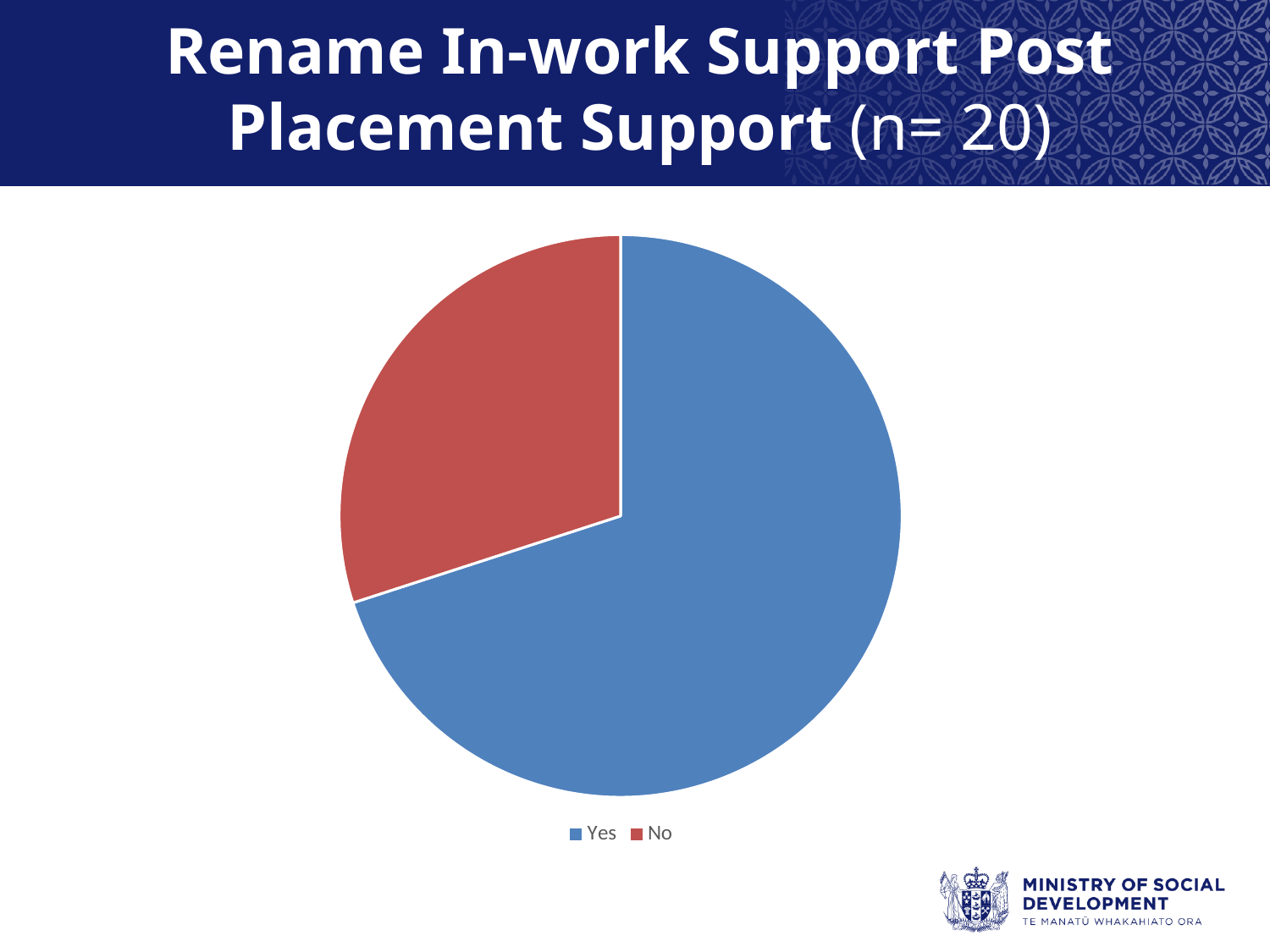
What colour is the No slice of the pie chart? red What are the two categories listed in the legend? Yes and No Which category has the largest slice of the pie? Yes Which is larger, the Yes slice or the No slice? Yes Which category has the smallest slice of the pie? No What kind of chart is shown on the slide? pie chart How many entries does the legend list? 2 How many slices does the pie chart have? 2